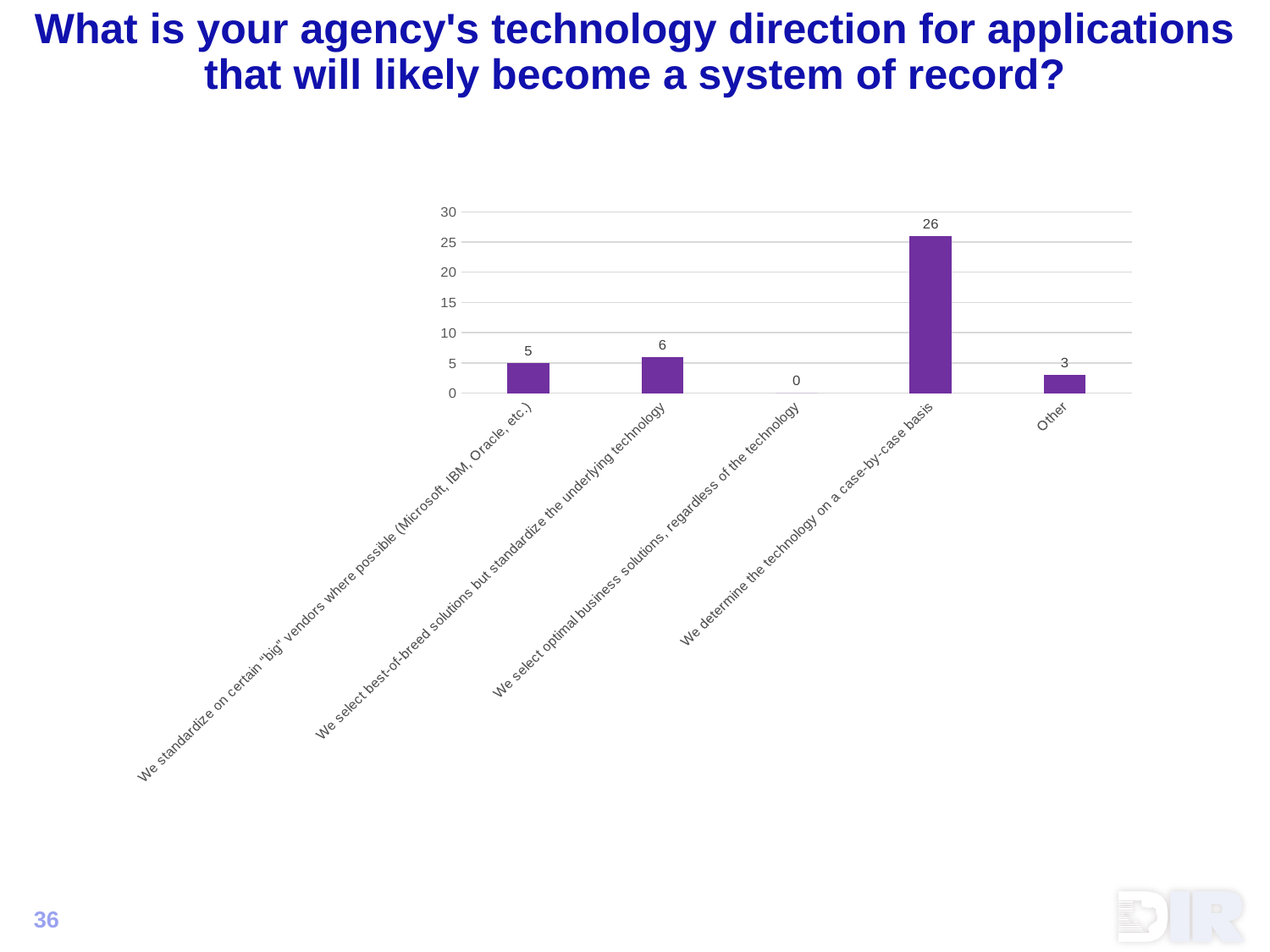
How many categories are shown on the x axis? 5 What is the value for "Other"? 3 Which is larger: the value for "We select best-of-breed solutions but standardize the underlying technology" or the value for "Other"? We select best-of-breed solutions but standardize the underlying technology What is the value for "We determine the technology on a case-by-case basis"? 26 What is the value for "We select optimal business solutions, regardless of the technology"? 0 Is the value for "We determine the technology on a case-by-case basis" greater or less than 20? greater What is the value for "We standardize on certain "big" vendors where possible (Microsoft, IBM, Oracle, etc.)"? 5 Which category has the lowest value? We select optimal business solutions, regardless of the technology Which category has the highest value? We determine the technology on a case-by-case basis What is the difference between the value for "We determine the technology on a case-by-case basis" and the value for "We select best-of-breed solutions but standardize the underlying technology"? 20 What is the value for "We select best-of-breed solutions but standardize the underlying technology"? 6 What kind of chart is shown on the slide? bar chart